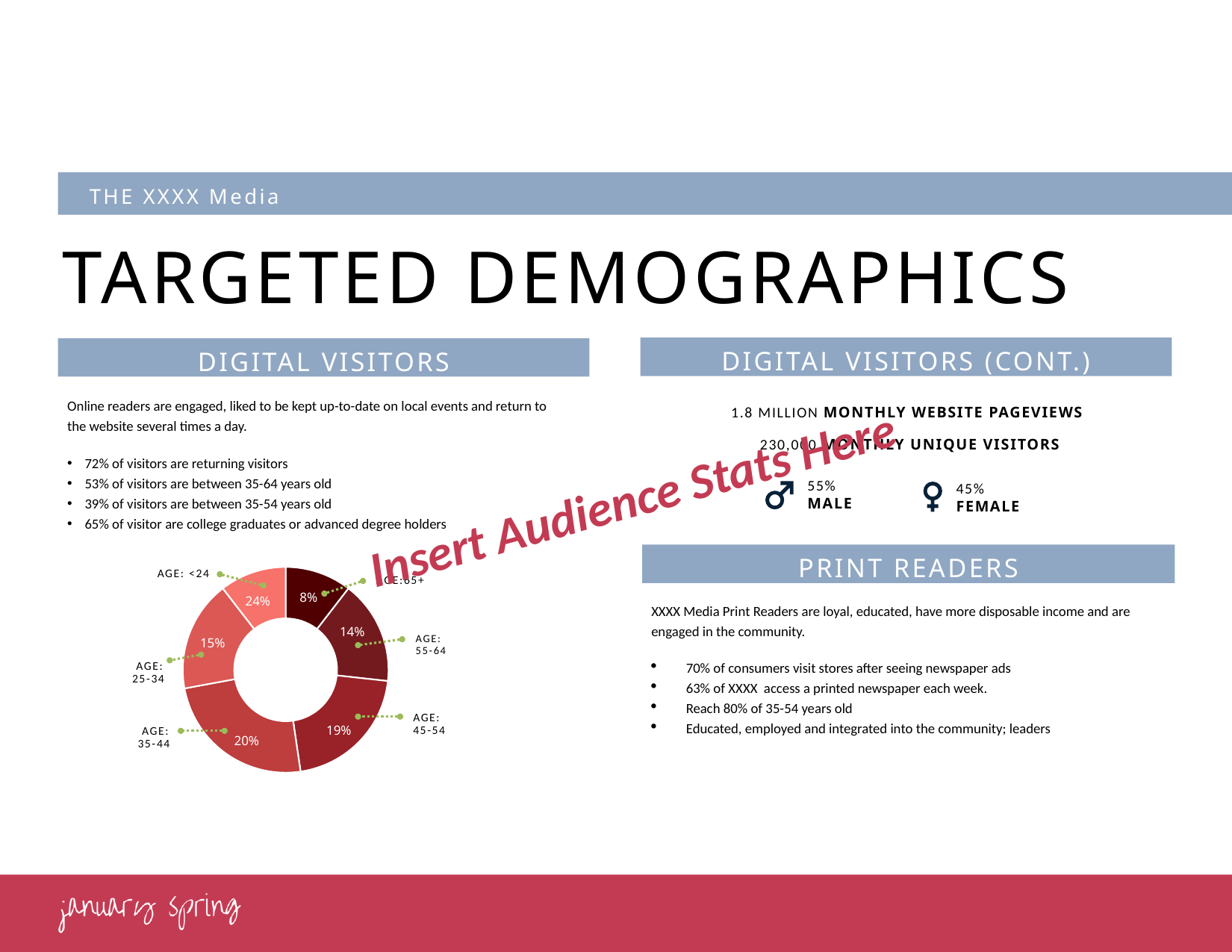
What is the combined share of the AGE: 35-44 and AGE: 45-54 slices in the donut chart? 39% What percentage does the AGE: 35-44 slice show in the donut chart? 20% What percentage of digital visitors are in the AGE: <24 group in the donut chart? 24% Under which section heading does the donut chart appear? DIGITAL VISITORS Which slice is larger in the donut chart, AGE: 45-54 or AGE: 55-64? AGE: 45-54 What type of chart is used to show the age breakdown of digital visitors? Donut (pie) chart How many percentage points larger is the AGE: 35-44 slice than the AGE: 25-34 slice? 5% Which age group has the largest share in the donut chart? AGE: <24 What percentage is shown for the AGE: 25-34 slice in the donut chart? 15% Which age group has the smallest share in the donut chart? AGE: 65+ How many age groups are shown in the donut chart? 6 What value is shown for the AGE: 55-64 slice in the donut chart? 14%